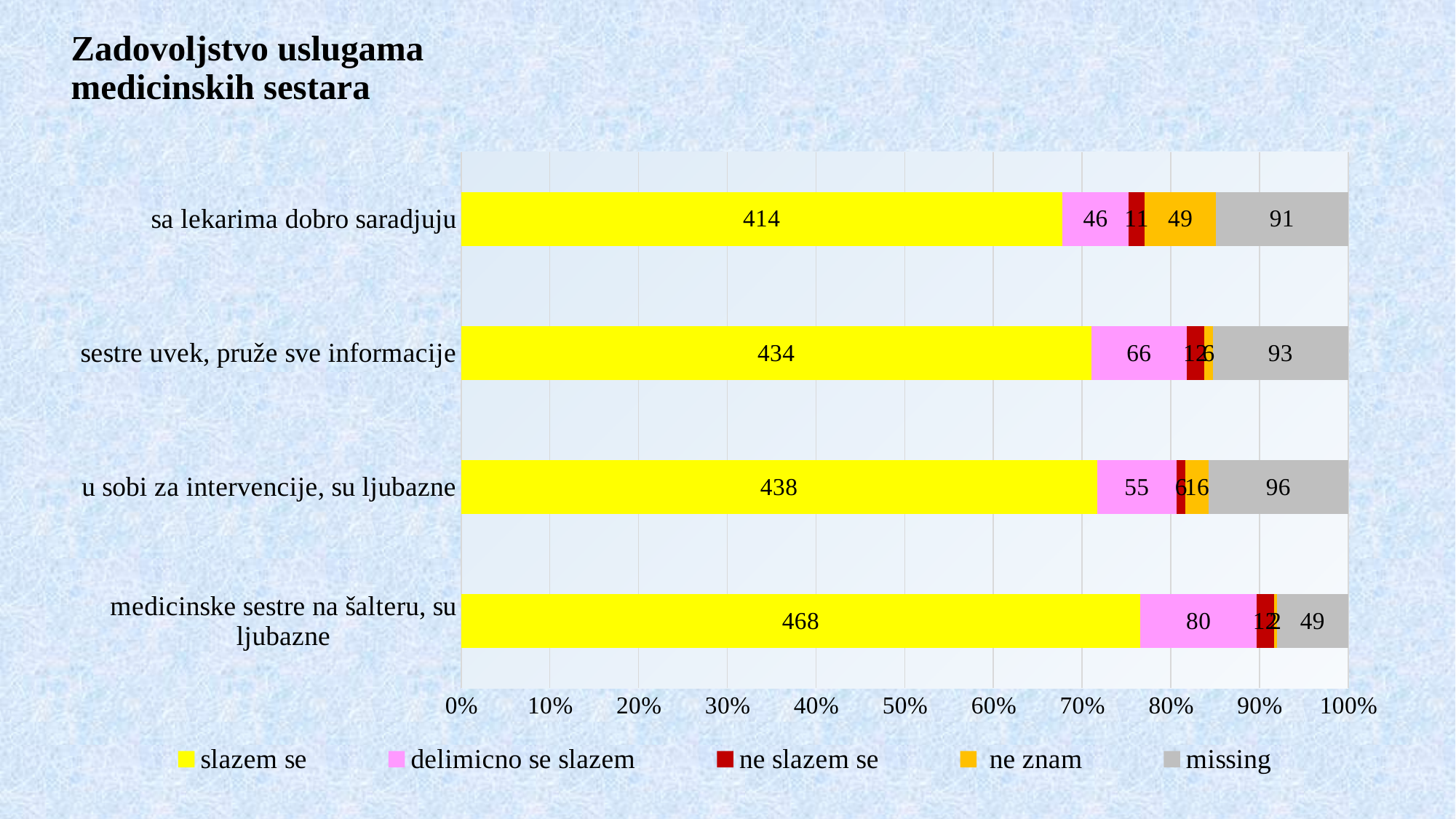
Is the 'slazem se' share of the bar for 'sa lekarima dobro saradjuju' greater or less than 70%? less How many categories are shown on the chart? 4 What is the 'ne znam' value for 'sa lekarima dobro saradjuju'? 49 What is the difference between the 'slazem se' values for 'medicinske sestre na šalteru, su ljubazne' and 'sa lekarima dobro saradjuju'? 54 What is the 'missing' value for 'u sobi za intervencije, su ljubazne'? 96 What is the value of 'slazem se' for 'sa lekarima dobro saradjuju'? 414 Which category has the highest 'slazem se' value? medicinske sestre na šalteru, su ljubazne How many series does the legend list? 5 What is the 'delimicno se slazem' value for 'medicinske sestre na šalteru, su ljubazne'? 80 What kind of chart is shown on the slide? Stacked bar chart Which is larger: the 'delimicno se slazem' value for 'sestre uvek, pruže sve informacije' or for 'u sobi za intervencije, su ljubazne'? sestre uvek, pruže sve informacije Which category has the lowest 'slazem se' value? sa lekarima dobro saradjuju